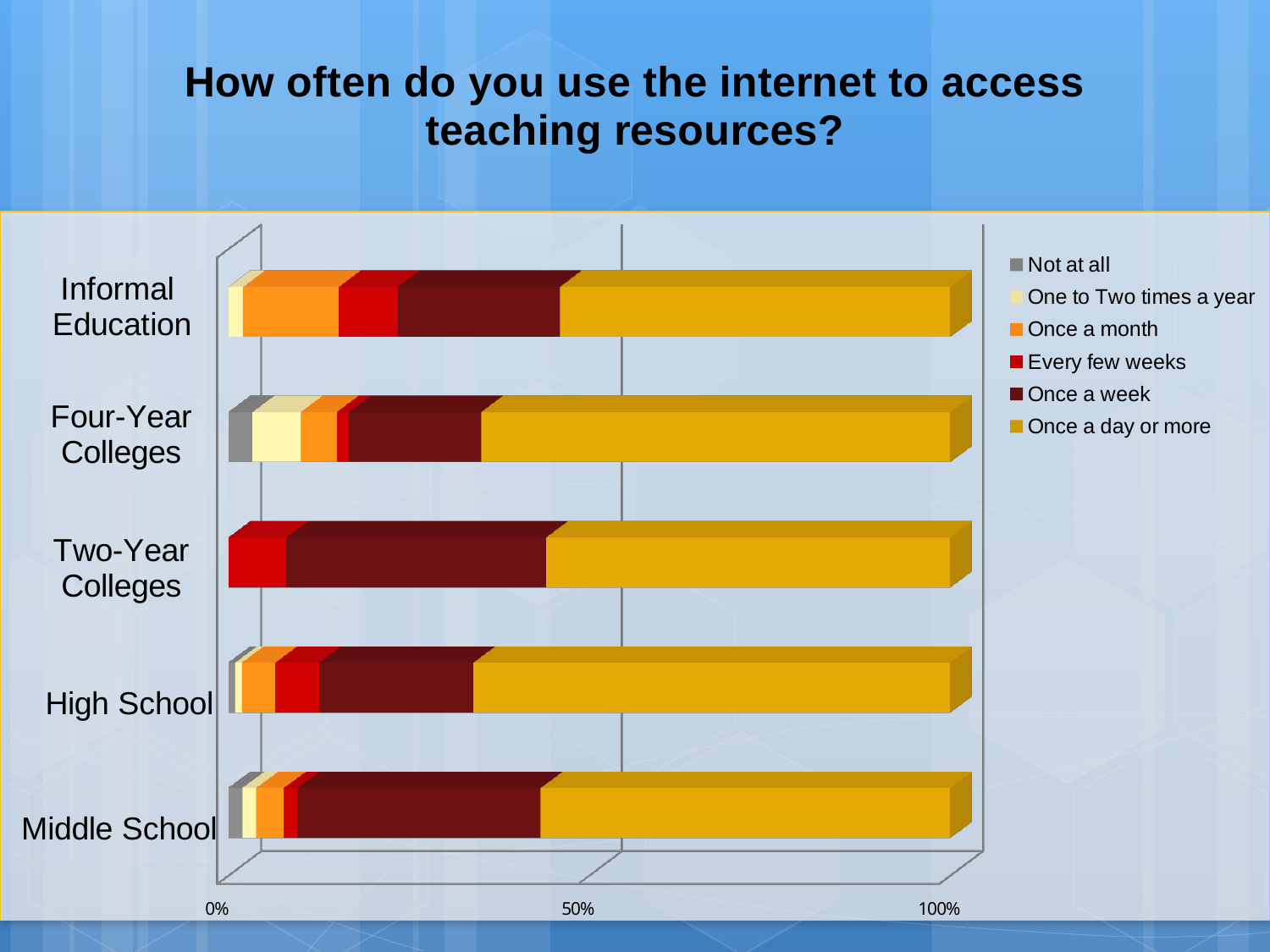
Which legend entry is shown in yellow-gold? Once a day or more How many categories are plotted on the chart? 5 Is the value for Once a day or more for High School greater or less than 50%? greater What is the title of the chart? How often do you use the internet to access teaching resources? Which has the larger Once a month share, Informal Education or Middle School? Informal Education What kind of chart is shown on the slide? Stacked bar chart Is the value for Once a day or more for Four-Year Colleges greater or less than 50%? greater Which category has the largest Not at all share? Four-Year Colleges Which has the larger Once a week share, Two-Year Colleges or Four-Year Colleges? Two-Year Colleges Which category has the largest Once a month share? Informal Education How many series does the legend list? 6 Is the value for Once a week for Two-Year Colleges greater or less than 50%? less